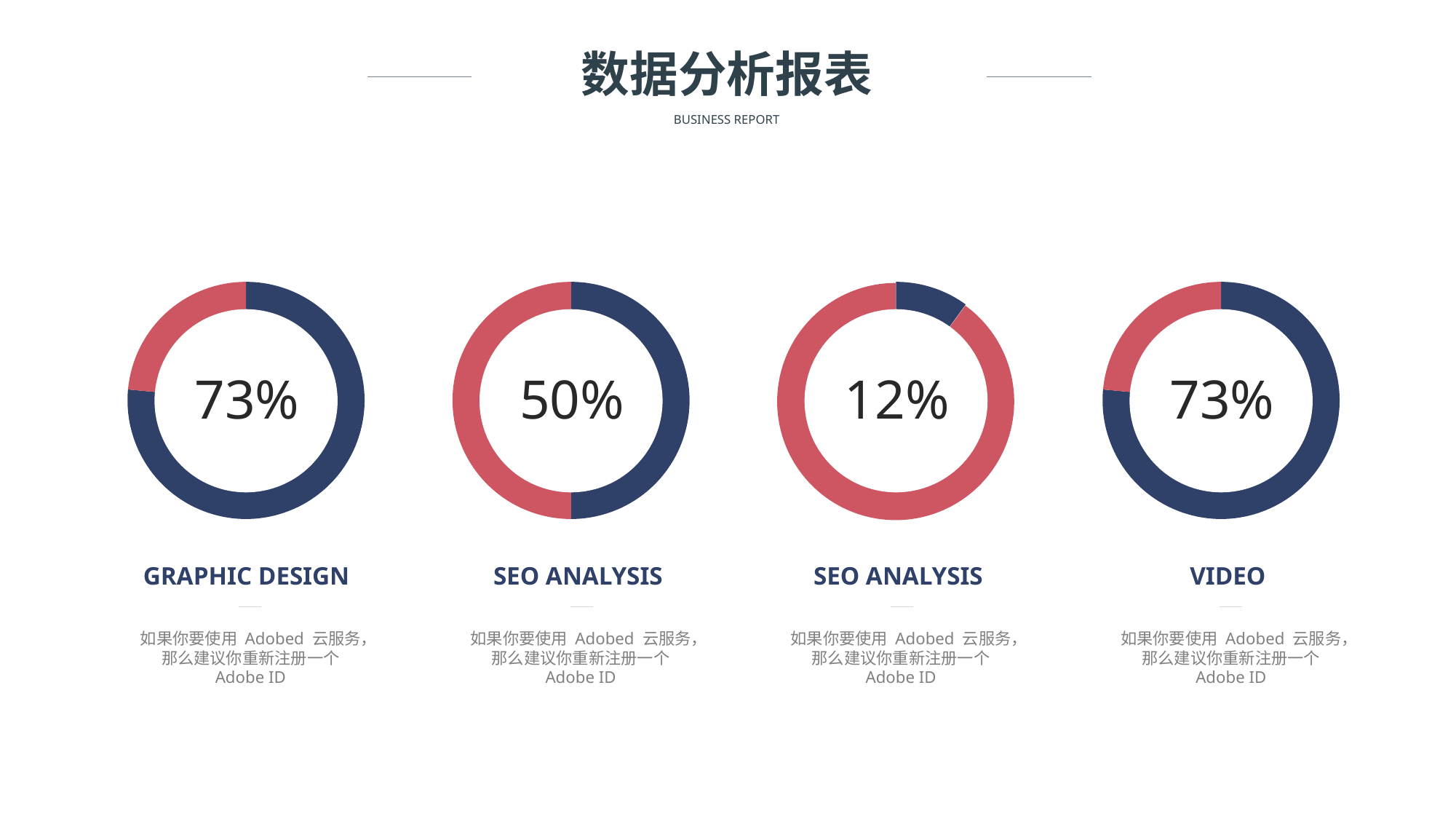
Which chart shows the lowest percentage? The third chart from the left (SEO ANALYSIS, 12%) What is the difference between the percentage in the GRAPHIC DESIGN chart and the percentage in the third chart from the left (SEO ANALYSIS)? 61% What percentage is shown in the GRAPHIC DESIGN donut chart? 73% What percentage is shown in the VIDEO donut chart? 73% What is the difference between the percentage in the second chart from the left (SEO ANALYSIS) and the third chart from the left (SEO ANALYSIS)? 38% What colour is the filled portion of the donut charts that represents the stated percentage? Dark blue How many donut charts are on the slide? 4 Which is larger: the percentage in the VIDEO chart or the percentage in the second chart from the left (SEO ANALYSIS)? VIDEO What percentage is shown in the second donut chart from the left, labelled SEO ANALYSIS? 50% What percentage is shown in the third donut chart from the left, labelled SEO ANALYSIS? 12% What kind of chart is used for each of the four values on the slide? Donut chart What is the title of the slide? 数据分析报表